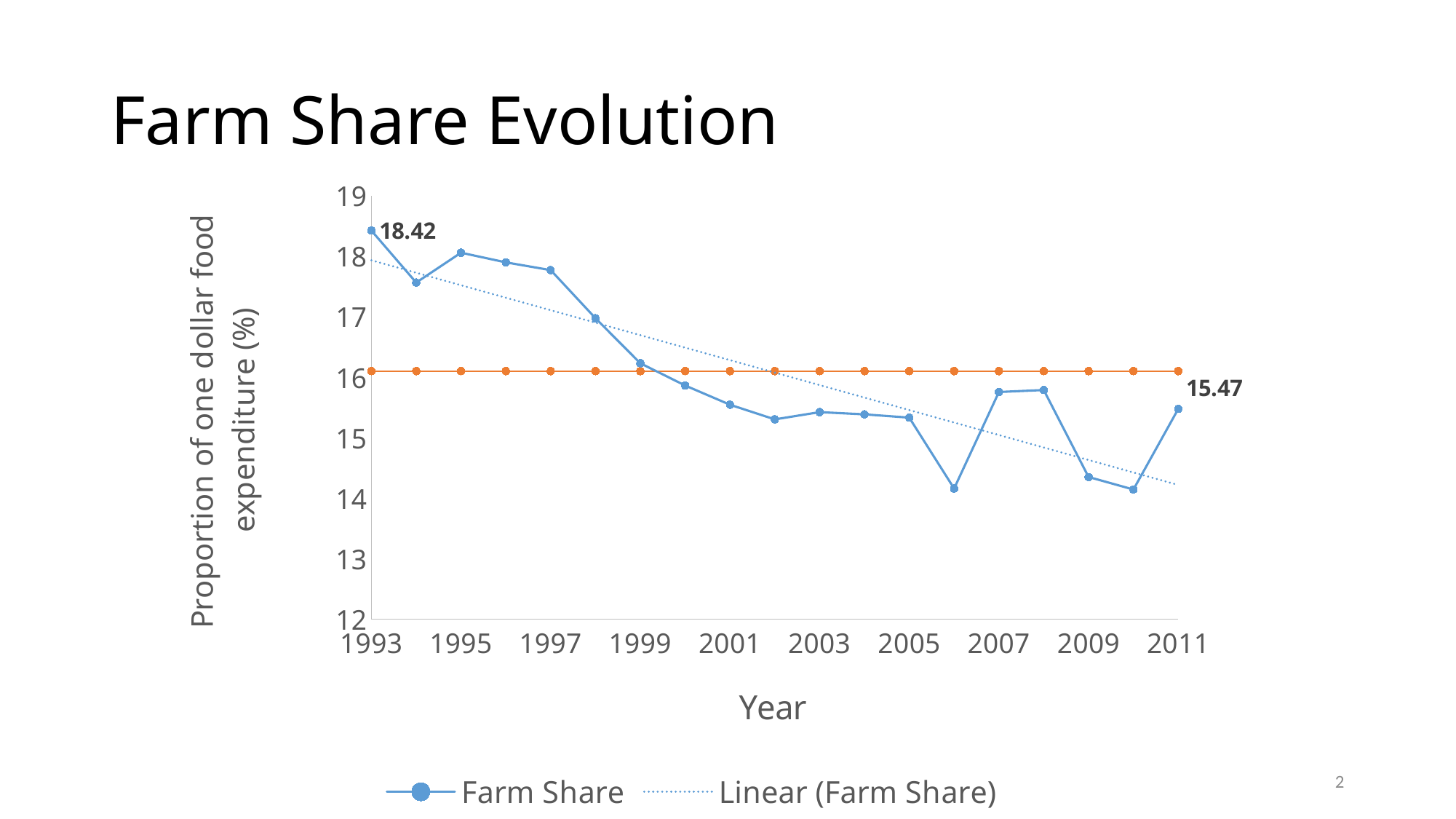
How many entries does the legend list? 2 Which year has the higher Farm Share value, 1993 or 2011? 1993 Is the Farm Share value for 2007 greater or less than 15? greater Is the Farm Share value for 2001 greater or less than 16? less What kind of chart is shown on the slide? line chart What is the Farm Share value for 1993? 18.42 What is the Farm Share value for 2011? 15.47 In which year is the Farm Share value highest? 1993 By how much did the Farm Share value fall from 1993 to 2011? 2.95 Does the Farm Share value generally rise or fall from 1993 to 2011? fall What is the label of the x axis? Year Is the Farm Share value for 2006 greater or less than 15? less